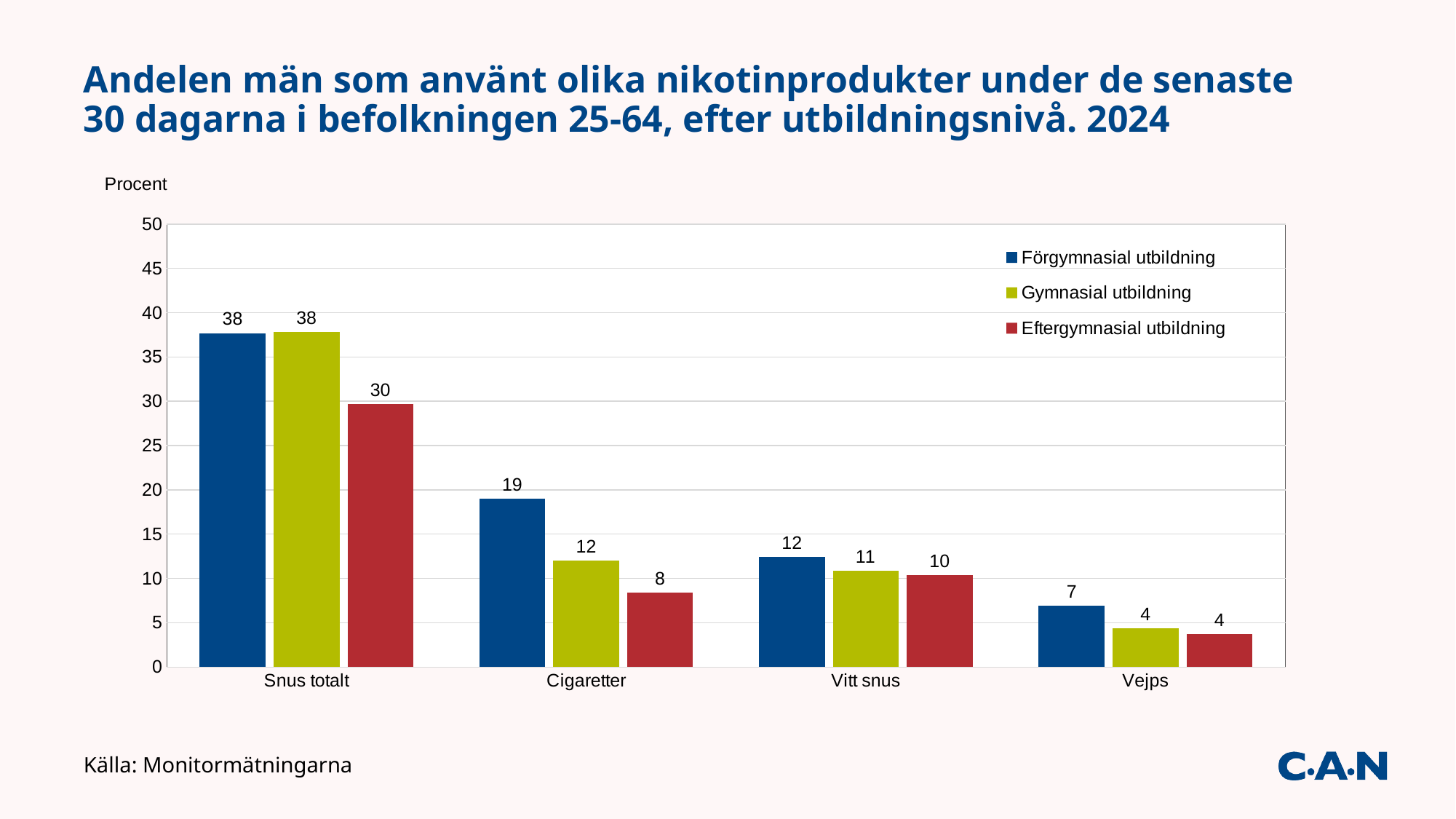
What is the value for Gymnasial utbildning in the Vitt snus category? 11 What is the value for Förgymnasial utbildning in the Cigaretter category? 19 Which category has the lowest value for Eftergymnasial utbildning? Vejps What source is cited at the bottom of the slide? Monitormätningarna Which category has the highest value for Förgymnasial utbildning? Snus totalt What kind of chart is shown on the slide? Bar chart How many series does the legend list? 3 How many categories are shown on the x axis? 4 What is the label on the y axis? Procent What is the value for Eftergymnasial utbildning in the Snus totalt category? 30 What is the difference between Förgymnasial utbildning and Eftergymnasial utbildning in the Cigaretter category? 11 Which is larger in the Vejps category: Förgymnasial utbildning or Gymnasial utbildning? Förgymnasial utbildning